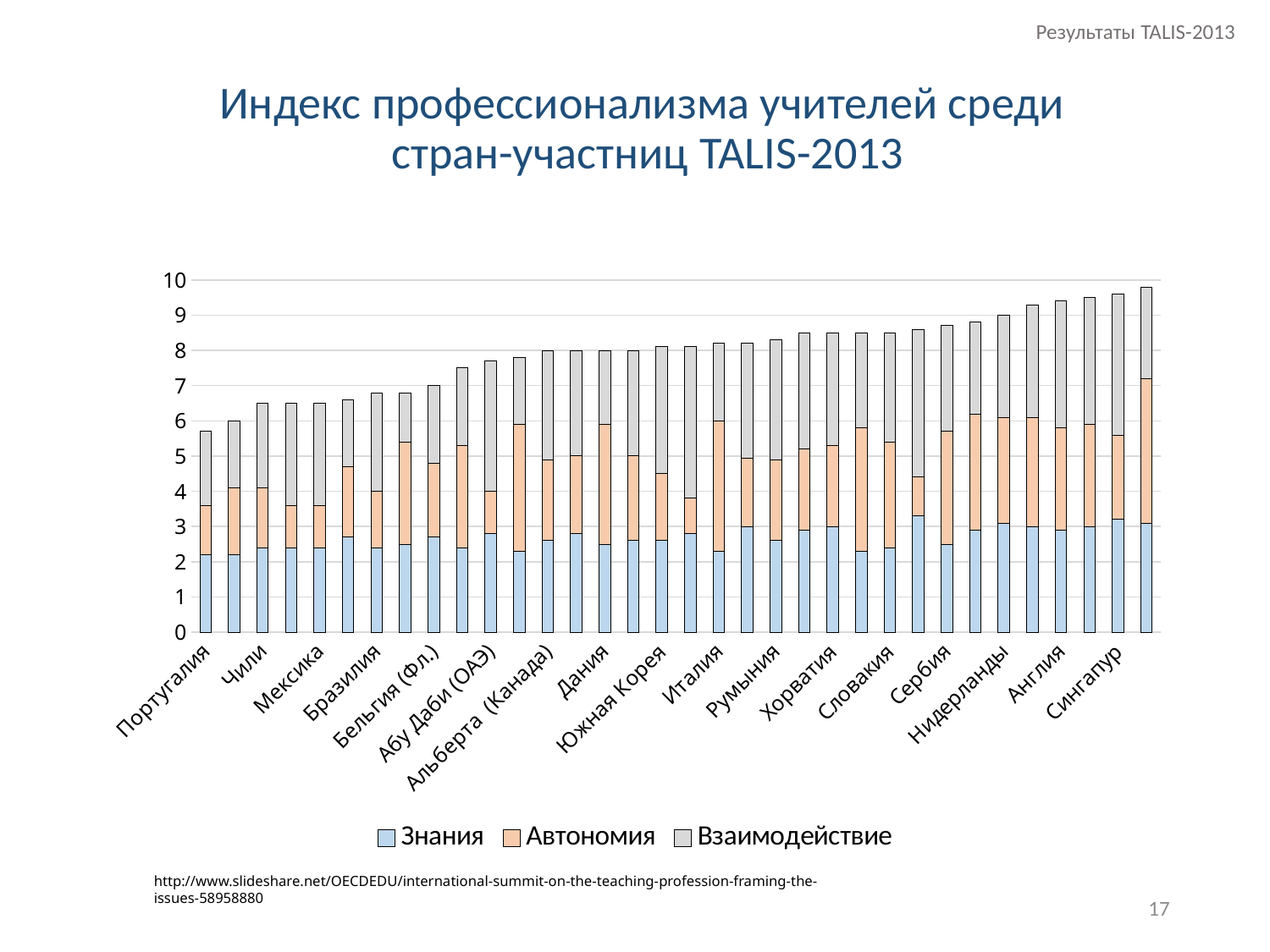
Which has the larger total index value, Мексика or Сербия? Сербия Is the total value for Мексика greater or less than 7? less Is the total value for Сингапур greater or less than 9? greater Is the total value for Англия greater or less than 9? greater Do the total bar heights rise or fall from left to right along the x axis? rise How many series does the legend list? 3 What are the three series listed in the legend? Знания, Автономия, Взаимодействие What kind of chart is shown on the slide? Stacked bar chart Which series is shown in blue? Знания Which country has the lowest total index value? Португалия